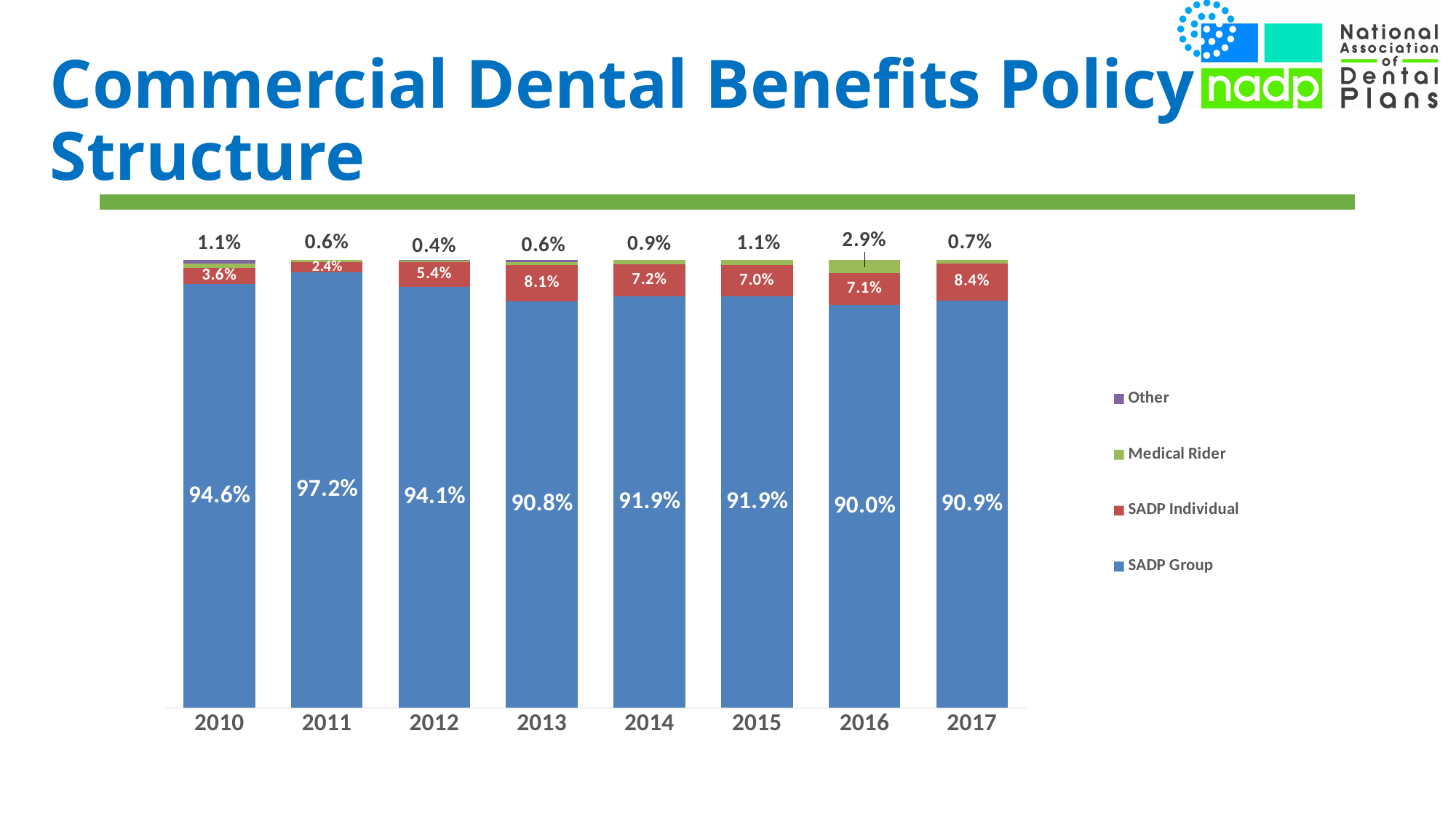
In which year is the SADP Group share lowest? 2016 What is the Medical Rider share in 2016? 2.9% In which year is the SADP Group share highest? 2011 How many years are shown on the x axis? 8 What kind of chart is shown on the slide? Stacked bar chart In which year is the SADP Individual share highest? 2017 By how many percentage points does the SADP Group share in 2010 exceed that in 2017? 3.7 percentage points What is the SADP Group share in 2011? 97.2% In which year is the SADP Individual share lowest? 2011 What is the SADP Individual share in 2017? 8.4% How many series does the legend list? 4 Which year has the larger SADP Individual share, 2013 or 2014? 2013